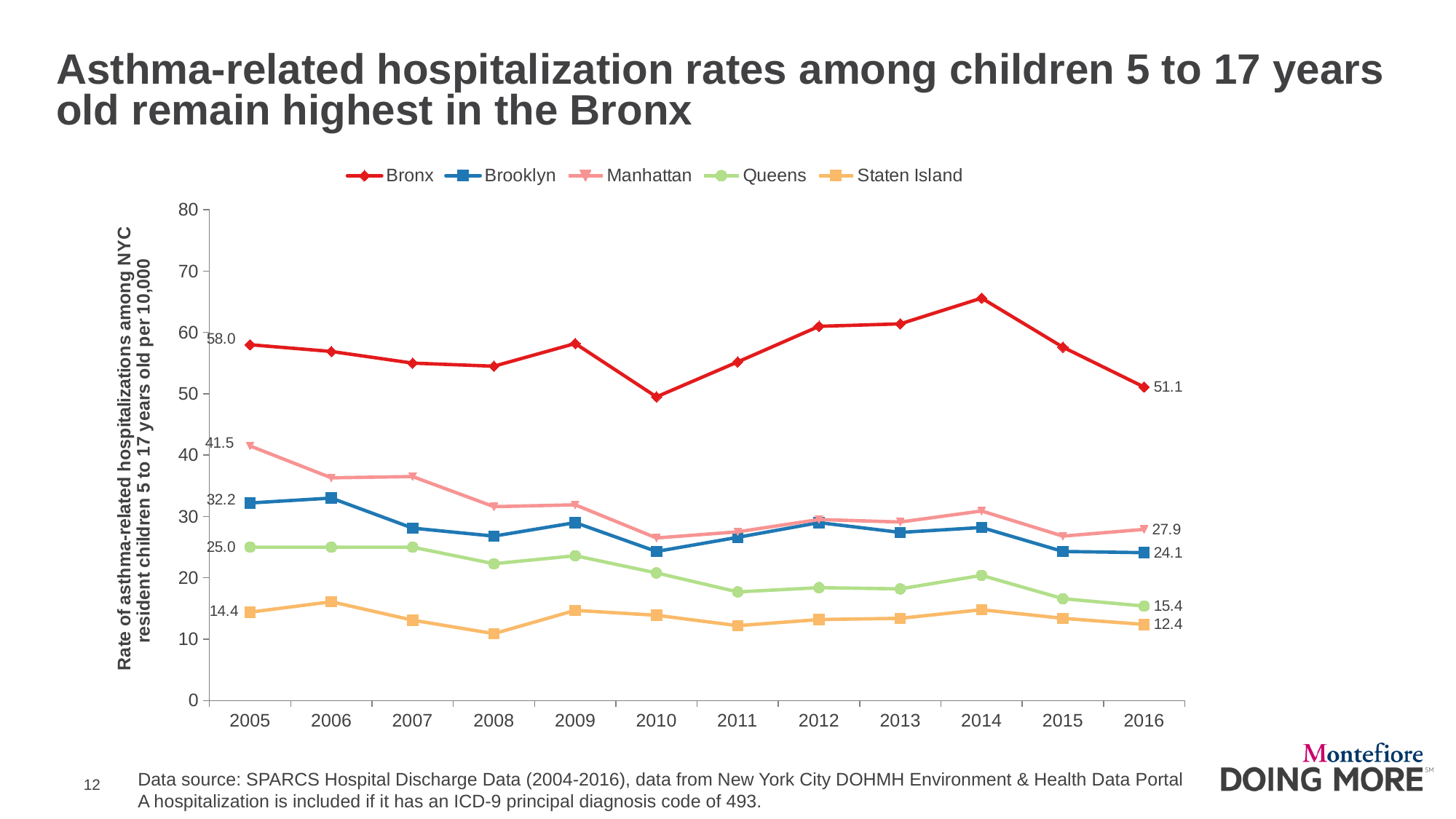
What was the Manhattan rate in 2005? 41.5 Which borough had the lowest hospitalization rate in 2005? Staten Island What type of chart is shown on the slide? Line chart What was the Bronx asthma-related hospitalization rate in 2016? 51.1 How many years are shown on the x axis? 12 By how much did the Bronx rate fall from 2005 to 2016? 6.9 How many series does the legend list? 5 Which was larger in 2016, the Brooklyn rate or the Queens rate? Brooklyn Which borough had the highest hospitalization rate in 2016? Bronx What was the Bronx asthma-related hospitalization rate in 2005? 58.0 Is the Bronx value for 2014 greater or less than 60? greater What was the Staten Island rate in 2016? 12.4